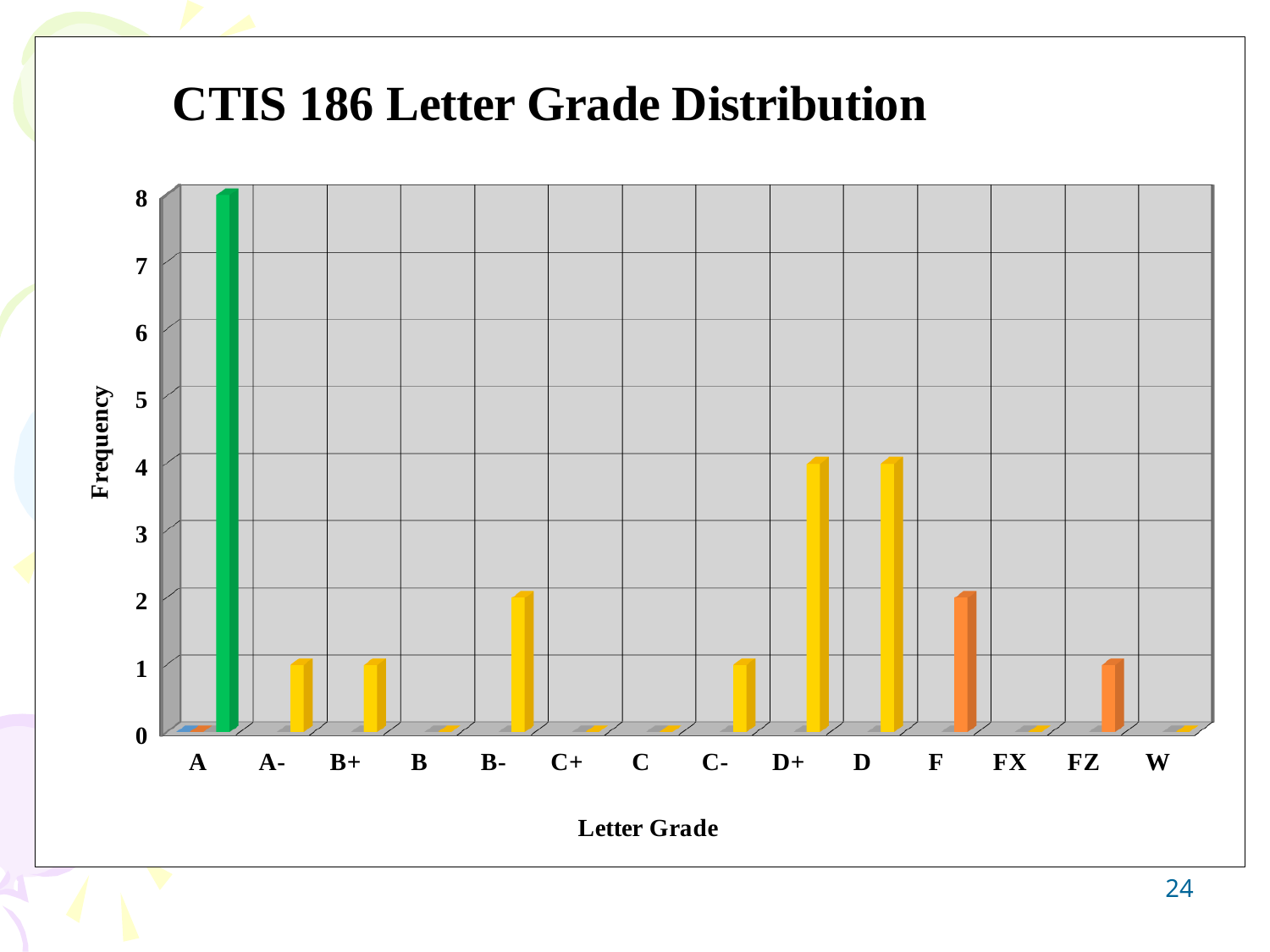
Which letter grade has the highest frequency? A What is the difference between the frequency for A and the frequency for D? 4 What is the label of the y axis? Frequency What is the frequency for letter grade A? 8 What is the frequency for letter grade FZ? 1 How many letter grade categories are shown on the x axis? 14 What is the frequency for letter grade D+? 4 Is the frequency for A greater or less than 6? greater What kind of chart is shown on the slide? bar chart What is the frequency for letter grade B-? 2 What is the title of the chart? CTIS 186 Letter Grade Distribution Which has a higher frequency, D+ or F? D+